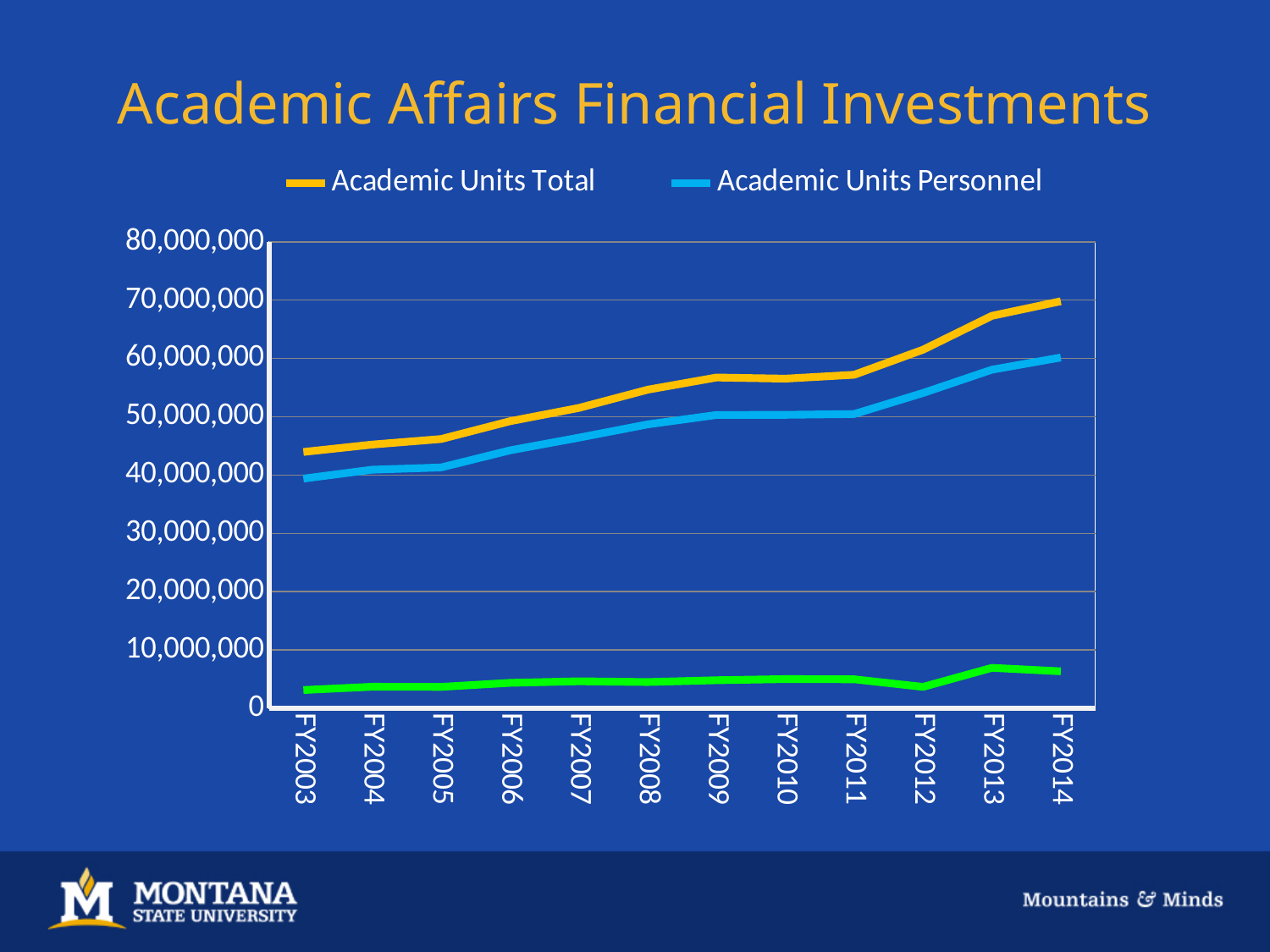
In which fiscal year is Academic Units Personnel lowest? FY2003 In FY2010, which is larger: Academic Units Total or Academic Units Personnel? Academic Units Total Which series is drawn in yellow? Academic Units Total In which fiscal year is Academic Units Total highest? FY2014 Is the Academic Units Total value for FY2013 greater or less than 70,000,000? less How many series does the legend list? 2 What kind of chart is shown on the slide? line chart Is the Academic Units Total value for FY2003 greater or less than 40,000,000? greater What is the title of the chart? Academic Affairs Financial Investments Do the Academic Units Total values generally rise or fall from FY2003 to FY2014? rise How many fiscal years are shown along the x axis? 12 Is the Academic Units Personnel value for FY2012 greater or less than 50,000,000? greater